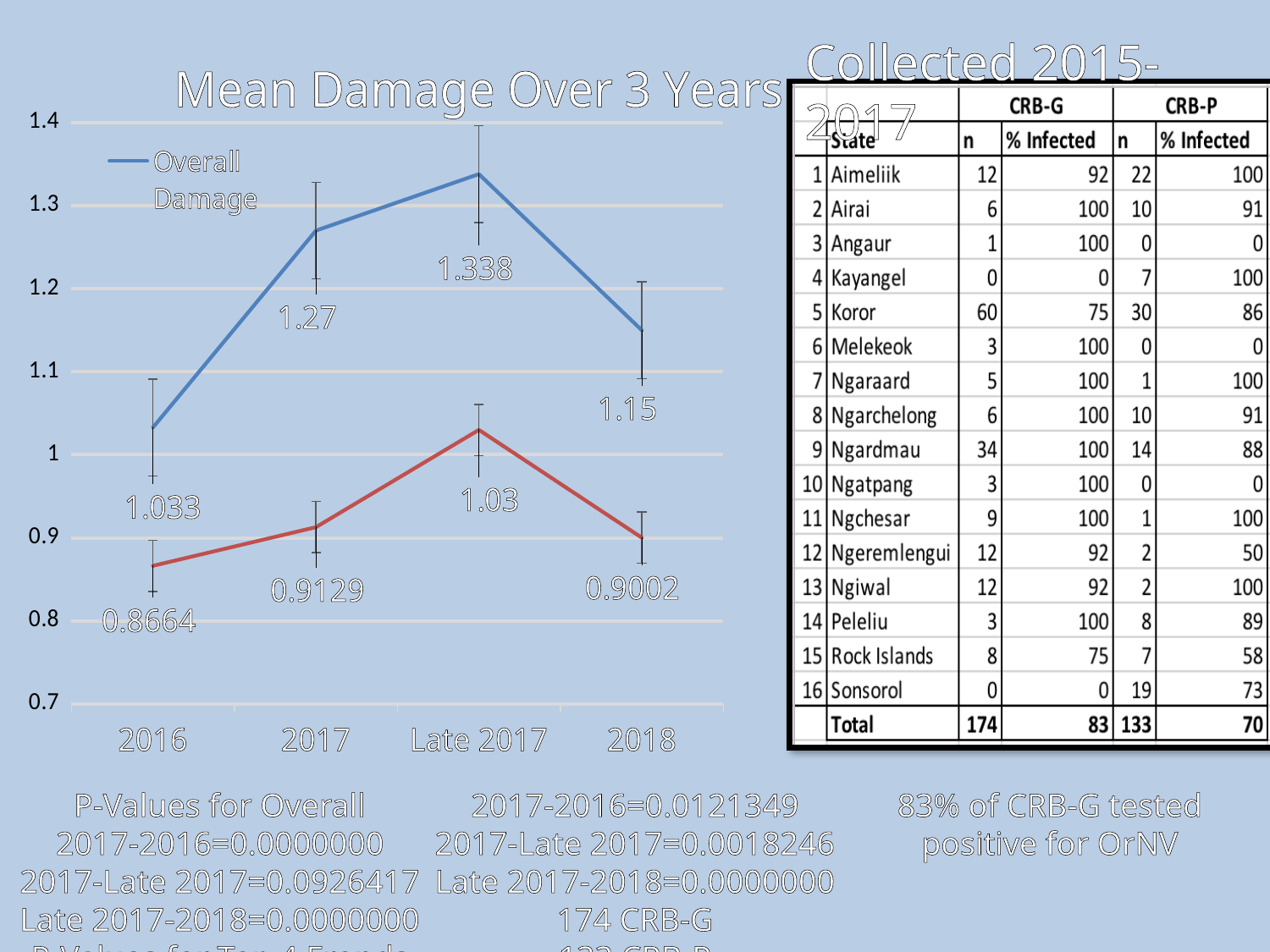
What is the Overall Damage value for 2018? 1.15 How many periods are shown on the x axis? 4 In which period is Overall Damage highest? Late 2017 Does Overall Damage rise or fall from 2016 to Late 2017? Rises Which is larger, the Overall Damage value for 2017 or for 2018? 2017 In which period is Overall Damage lowest? 2016 What is the difference between the Overall Damage values for Late 2017 and 2018? 0.188 What kind of chart is 'Mean Damage Over 3 Years'? Line chart What is the Overall Damage value for Late 2017? 1.338 What is the Overall Damage value for 2016? 1.033 What is the value of the red line for 2016? 0.8664 What is the value of the red line for 2017? 0.9129